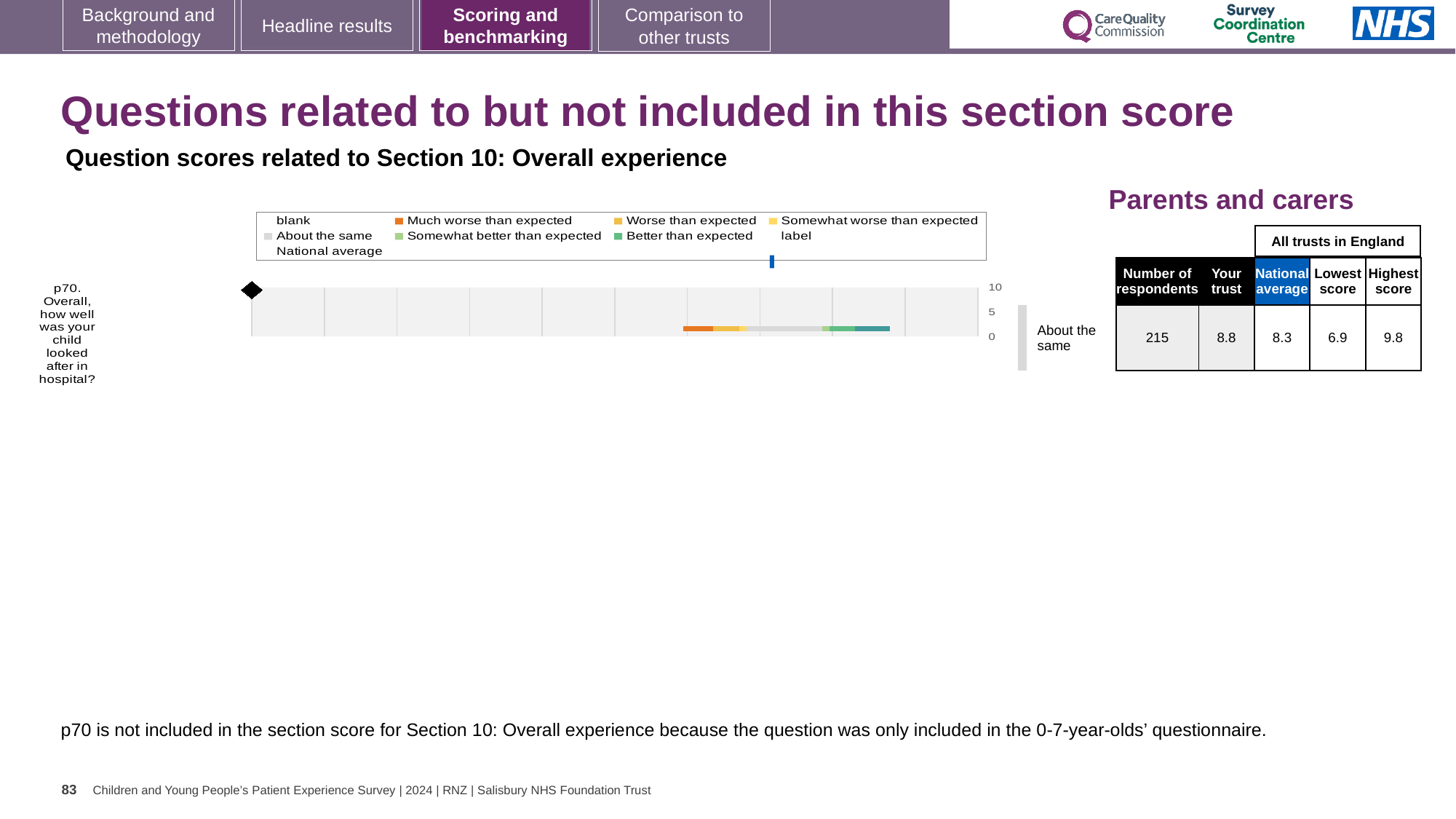
What is the national average score for p70? 8.3 What is the 'Your trust' score for p70 in the Parents and carers table? 8.8 Which colour in the legend represents 'Much worse than expected'? orange How many questions are plotted in the chart on this slide? 1 What is the difference between the 'Your trust' score and the national average for p70? 0.5 What is the highest score among all trusts in England for p70? 9.8 How many respondents answered question p70? 215 What kind of chart is shown on the slide for question p70? bar chart What is the lowest score among all trusts in England for p70? 6.9 What is the difference between the highest and lowest scores among all trusts in England for p70? 2.9 What benchmark category label is shown next to the bar for p70? About the same Which is larger for p70: the 'Your trust' score or the national average? Your trust